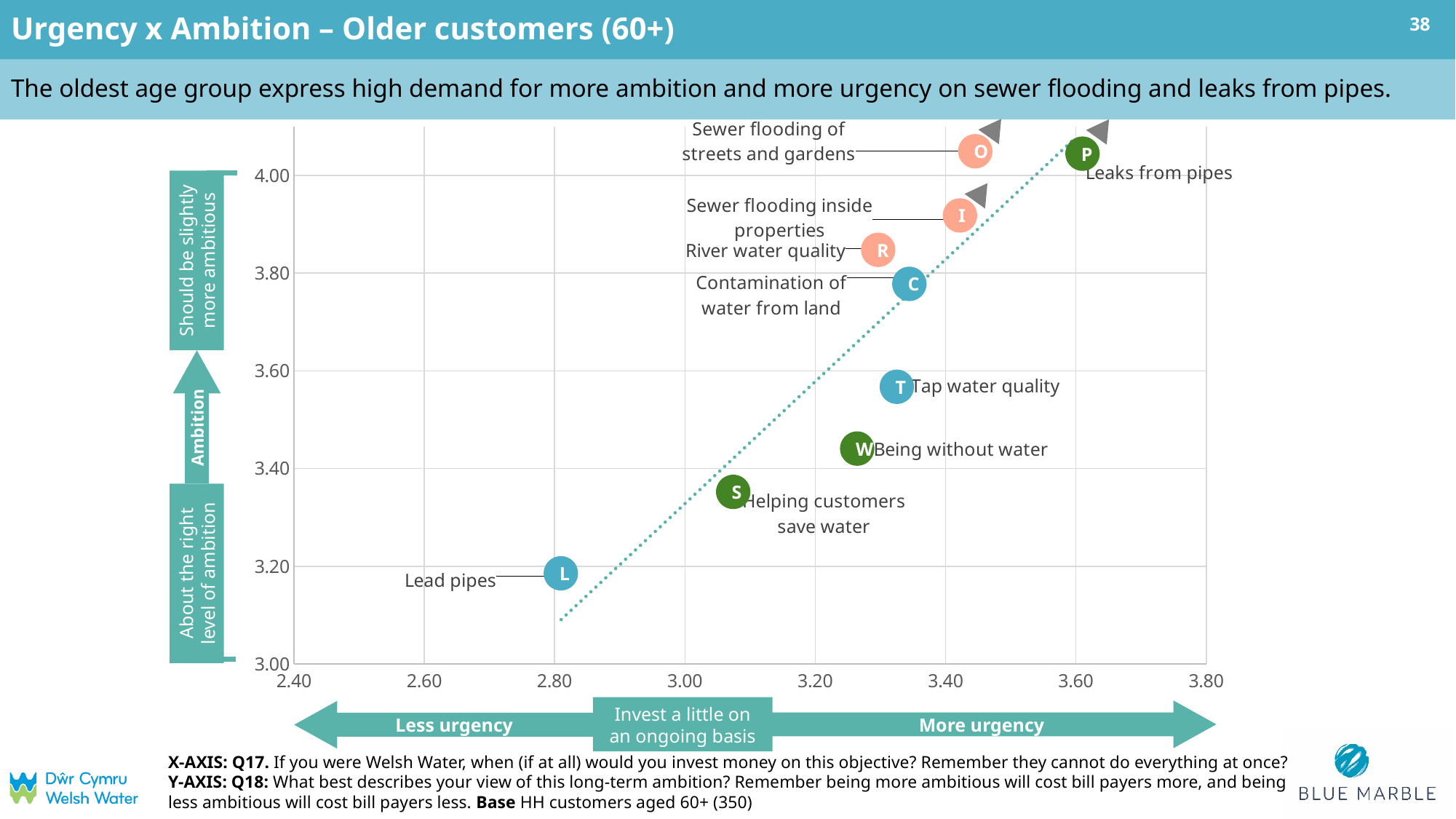
What kind of chart is shown on the slide? Scatter chart Is the ambition (y-axis) value for Sewer flooding inside properties greater or less than 3.80? greater Which objective has the highest urgency score (x-axis) on the chart? Leaks from pipes What is the title of the slide containing the chart? Urgency x Ambition – Older customers (60+) Which has a higher urgency (x-axis) score: Leaks from pipes or Sewer flooding of streets and gardens? Leaks from pipes Is the urgency (x-axis) value for Lead pipes greater or less than 3.00? less Which objective has the lowest ambition score (y-axis) on the chart? Lead pipes Is the ambition (y-axis) value for Being without water greater or less than 3.40? greater How many objectives (data points) are plotted on the chart? 9 Which has a higher ambition (y-axis) score: Tap water quality or Being without water? Tap water quality What letter is shown inside the marker for Lead pipes? L